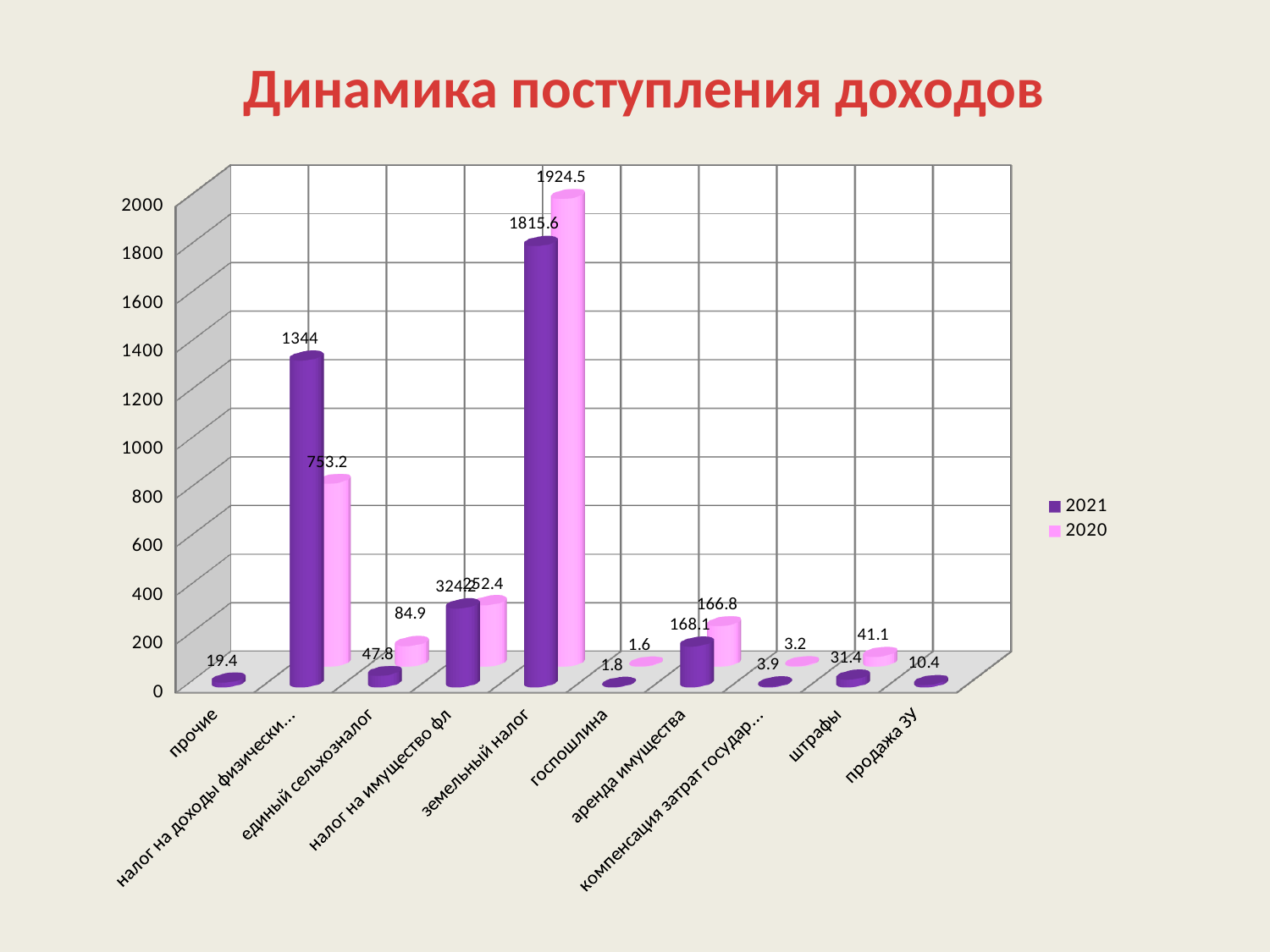
Which category has the highest value in the 2021 series? земельный налог What is the value for штрафы in the 2020 series? 41.1 What is the difference between the 2021 and 2020 values for налог на доходы физических лиц? 590.8 How many categories are shown on the x axis? 10 For единый сельхозналог, which series has the larger value, 2021 or 2020? 2020 What is the value for госпошлина in the 2021 series? 1.8 What is the value for земельный налог in the 2021 series? 1815.6 How many series does the legend list? 2 What is the difference between the 2020 and 2021 values for земельный налог? 108.9 What kind of chart is shown on the slide? bar chart Which category has the highest value in the 2020 series? земельный налог What is the value for налог на доходы физических лиц in the 2020 series? 753.2